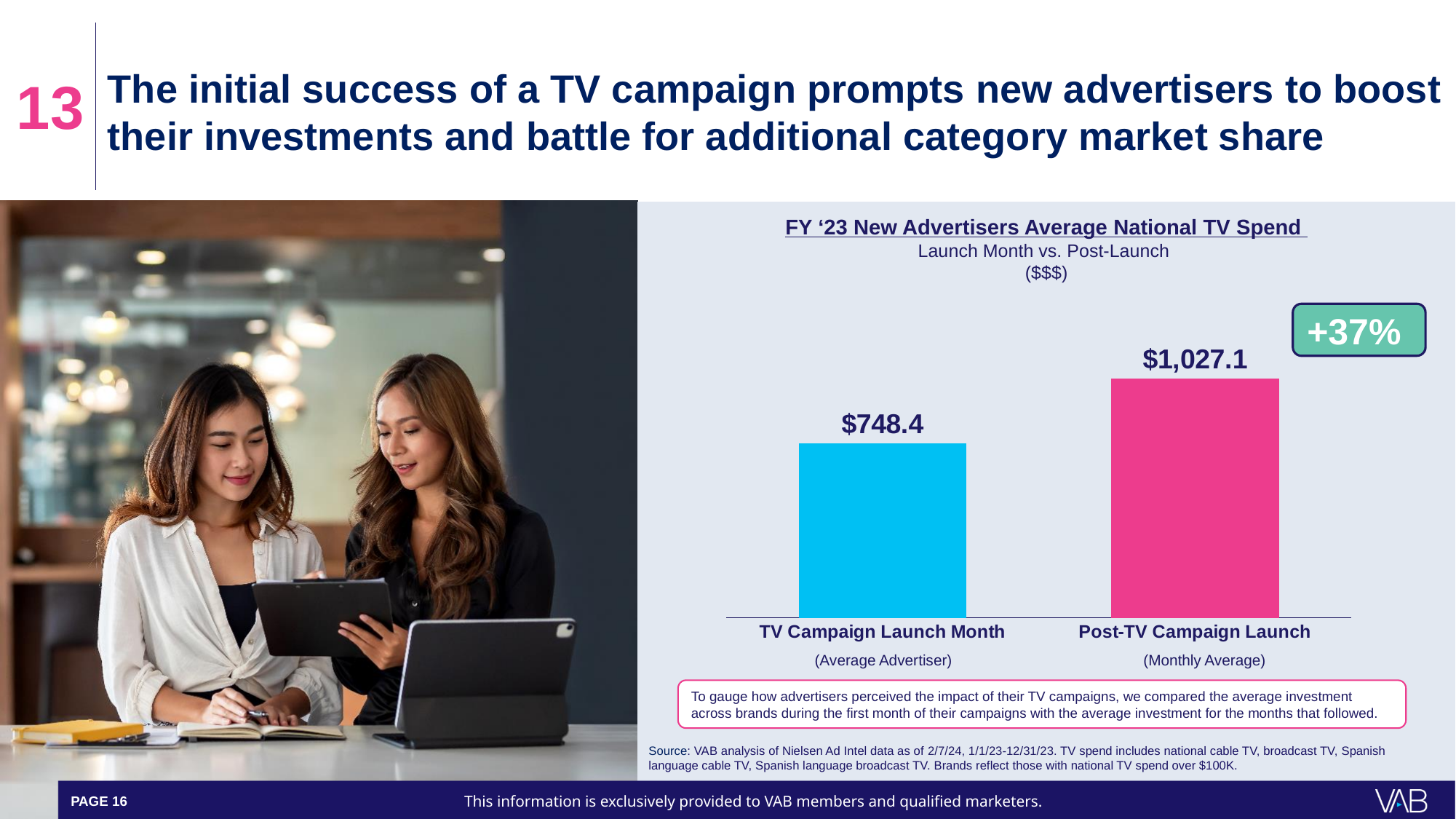
Which category has the lowest value? TV Campaign Launch Month What is the title of the chart? FY '23 New Advertisers Average National TV Spend What is the difference between the Post-TV Campaign Launch value and the TV Campaign Launch Month value? $278.7 Do the values rise or fall from TV Campaign Launch Month to Post-TV Campaign Launch? Rise What is the value for TV Campaign Launch Month? $748.4 What is the value for Post-TV Campaign Launch? $1,027.1 What percentage change is shown in the callout box on the chart? +37% Which category has the highest value? Post-TV Campaign Launch Which is larger, the value for TV Campaign Launch Month or the value for Post-TV Campaign Launch? Post-TV Campaign Launch How many categories are shown in the chart? 2 What kind of chart is shown on the slide? Bar chart